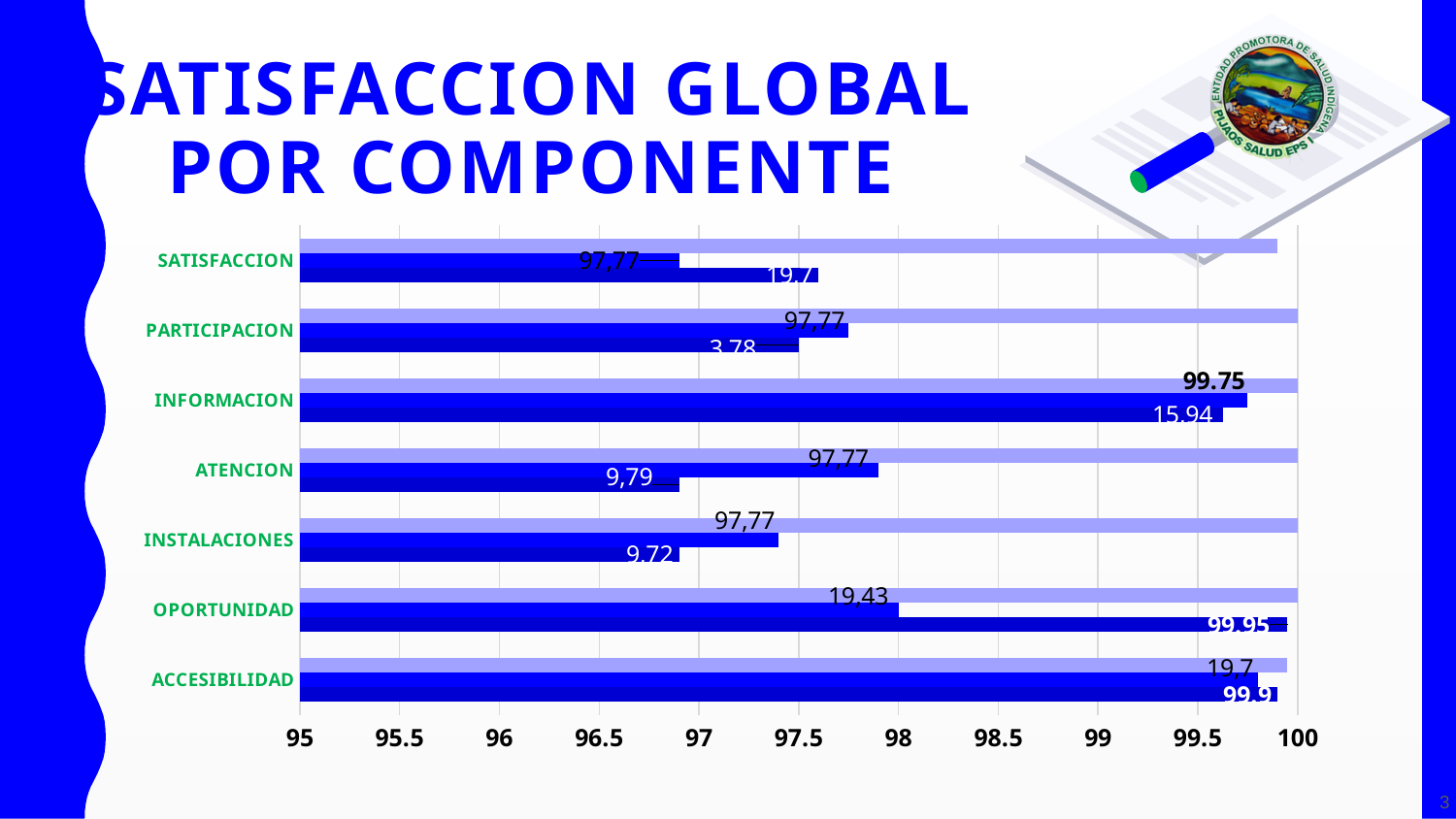
What is the title of the slide containing the chart? SATISFACCION GLOBAL POR COMPONENTE For OPORTUNIDAD, which bar is longer, the light blue bar or the dark blue bar? the light blue bar How many bars are plotted for each category in the chart? 3 For INSTALACIONES, which bar is longer, the light blue bar or the dark blue bar? the light blue bar What kind of chart is shown on the slide? bar chart Is the value of the dark blue bar for INFORMACION greater or less than 99? greater Is the value of the dark blue bar for INSTALACIONES greater or less than 98? less Which category has the shortest light blue bar? SATISFACCION How many categories are listed on the vertical axis of the chart? 7 Is the value of the dark blue bar for SATISFACCION greater or less than 98? less